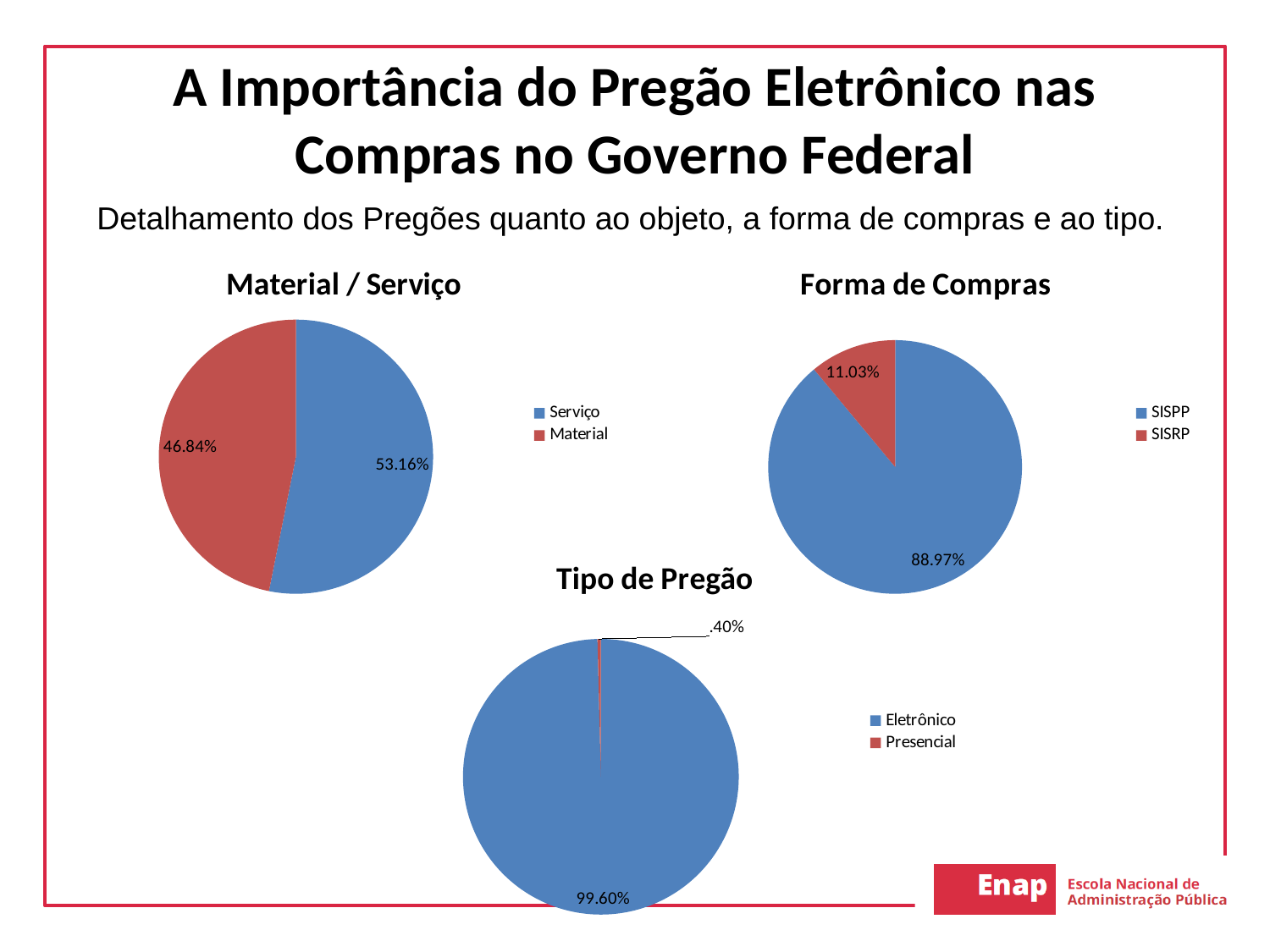
In the "Forma de Compras" chart, what is the value for SISRP? 11.03% In the "Tipo de Pregão" chart, what is the value for Presencial? .40% In the "Material / Serviço" chart, what is the value for Material? 46.84% In the "Material / Serviço" chart, what is the value for Serviço? 53.16% In the "Material / Serviço" chart, what is the difference between the Serviço and Material shares? 6.32% In the "Forma de Compras" chart, what is the value for SISPP? 88.97% In the "Forma de Compras" chart, which category has the smallest share? SISRP What kind of chart is the "Forma de Compras" chart? Pie chart In the "Tipo de Pregão" chart, which category has the largest share? Eletrônico In the "Tipo de Pregão" chart, what is the value for Eletrônico? 99.60% How many entries does the legend of the "Tipo de Pregão" chart list? 2 In the "Material / Serviço" chart, which slice is larger, Serviço or Material? Serviço